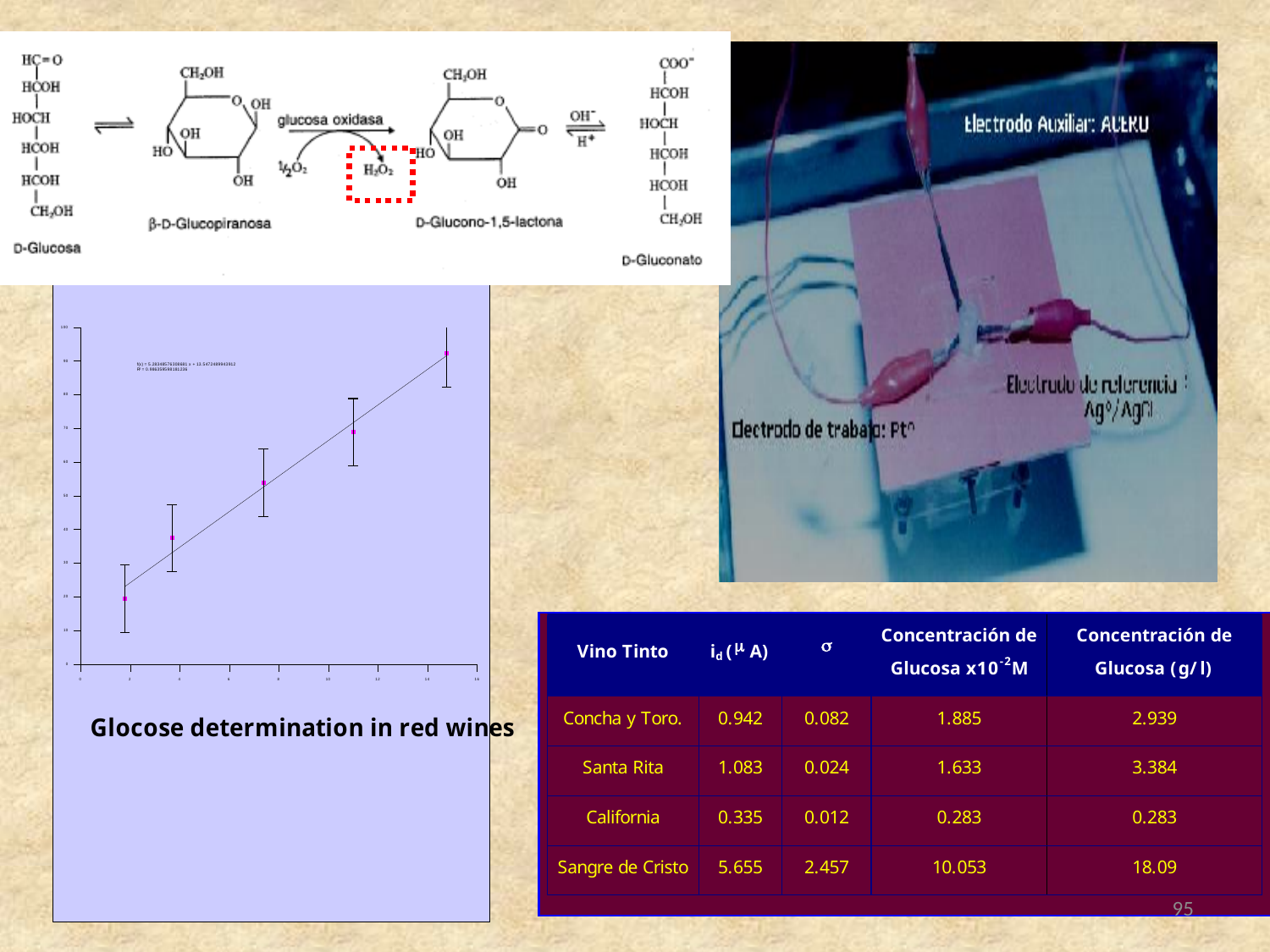
Is the value of the middle (third) data point greater or less than 50? greater Do the plotted values rise or fall as the x-axis value increases? rise Is the value of the highest data point greater or less than 80? greater Is the value of the second data point from the left greater or less than 30? greater What kind of chart is shown on the slide? line chart with data points and error bars What is the maximum value shown on the y-axis of the chart? 100 How many data points are plotted on the chart? 5 Which data point has the highest value, the leftmost or the rightmost? the rightmost What is the caption/title under the chart? Glocose determination in red wines